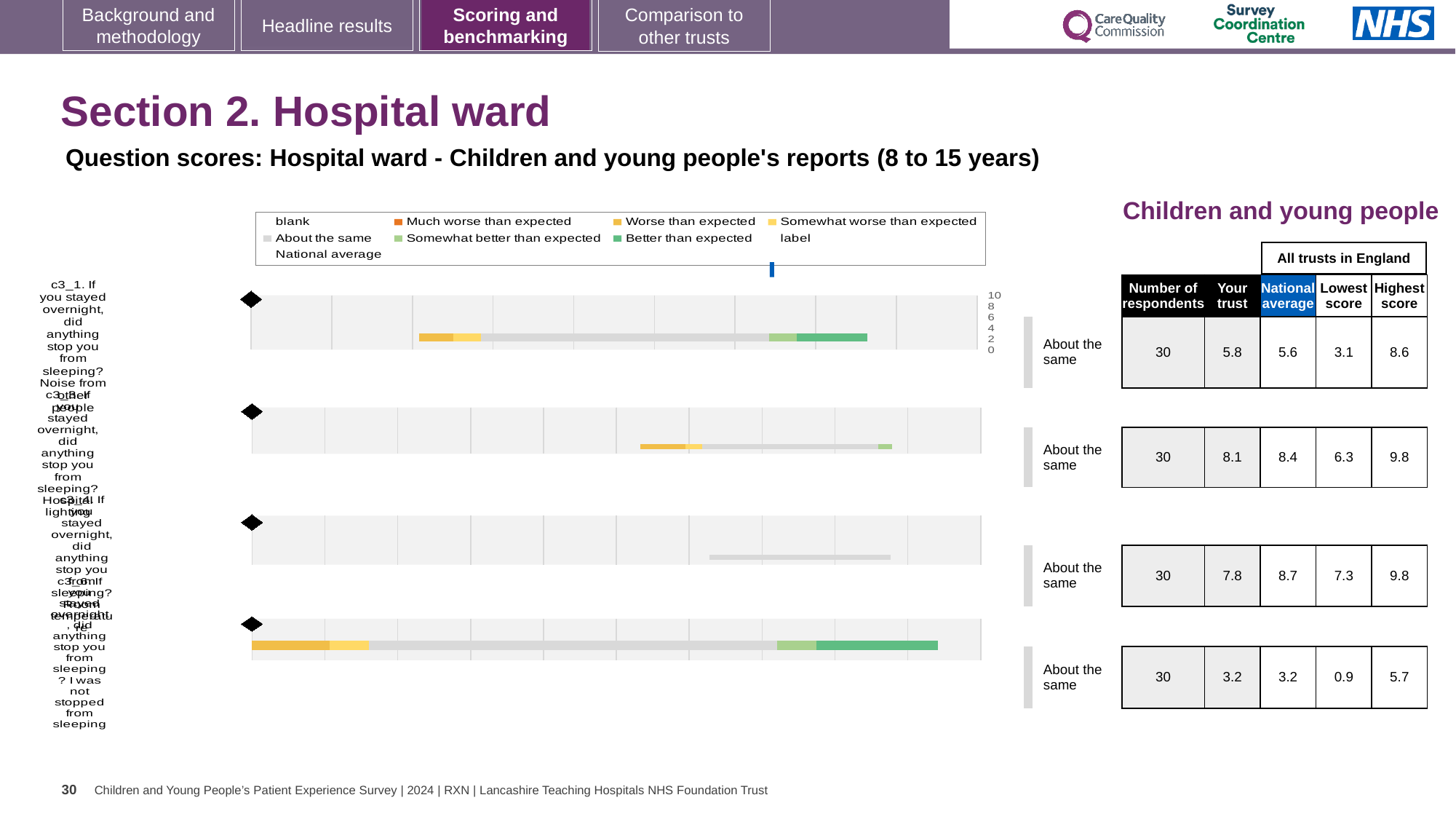
How many entries does the legend above the charts list? 9 For the top chart (c3_1), which is larger: the 'Your trust' score or the national average? Your trust Which of the four questions has the lowest 'Your trust' score? c3_6 (I was not stopped from sleeping), 3.2 For the top chart (c3_1, noise from other people), what is the 'Your trust' score shown in the table? 5.8 What benchmark category is shown to the right of each of the four charts? About the same For the second chart (c3_3, hospital lighting), what is the national average score? 8.4 How many benchmark bar charts are shown on the slide? 4 What kind of chart is used to show the benchmark ranges on this slide? bar chart How many respondents are listed for the top chart (c3_1)? 30 For the bottom chart (c3_6, I was not stopped from sleeping), what is the highest score among all trusts in England? 5.7 For the second chart (c3_3), what is the difference between the national average (8.4) and the 'Your trust' score (8.1)? 0.3 Which of the four questions has the highest 'Your trust' score? c3_3 (hospital lighting), 8.1